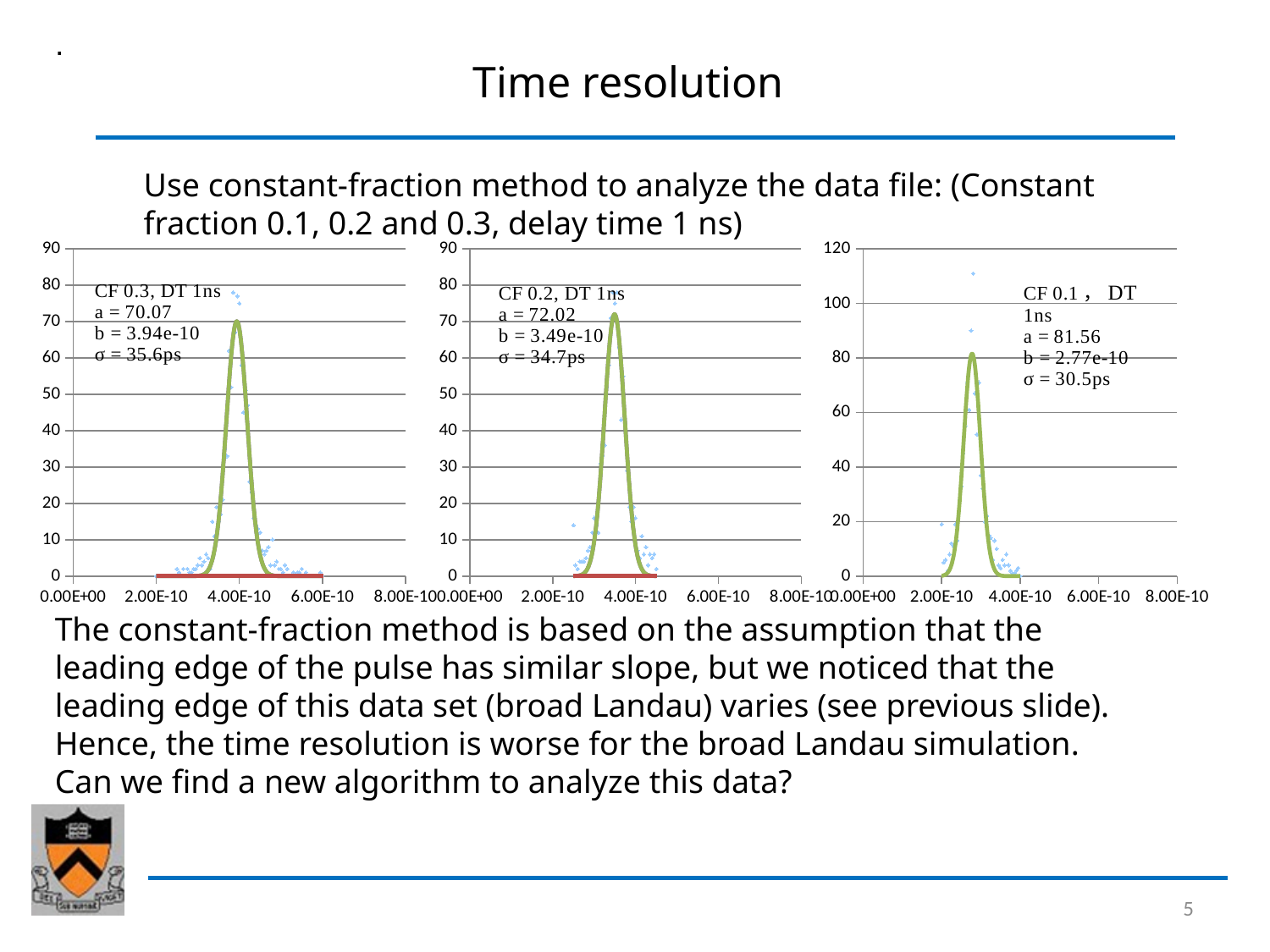
In the right chart (CF 0.1, DT 1ns), is the highest scatter point greater or less than 100? greater Is the fitted a value larger in the middle chart (CF 0.2) or the left chart (CF 0.3)? CF 0.2 What is the maximum value shown on the y axis of the right chart (CF 0.1, DT 1ns)? 120 Which of the three charts reports the largest fitted a value? CF 0.1, DT 1ns How many charts are shown on the slide? 3 What kind of chart is the left chart (CF 0.3, DT 1ns)? scatter chart with a fitted curve In the middle chart (CF 0.2, DT 1ns), what is the value of σ? 34.7ps What is the difference between the σ values of the CF 0.3 chart and the CF 0.1 chart? 5.1ps In the left chart (CF 0.3, DT 1ns), what is the fitted value of a? 70.07 Which of the three charts reports the smallest σ? CF 0.1, DT 1ns In the right chart (CF 0.1, DT 1ns), what is the value of σ? 30.5ps In the right chart (CF 0.1, DT 1ns), what is the fitted value of b? 2.77e-10